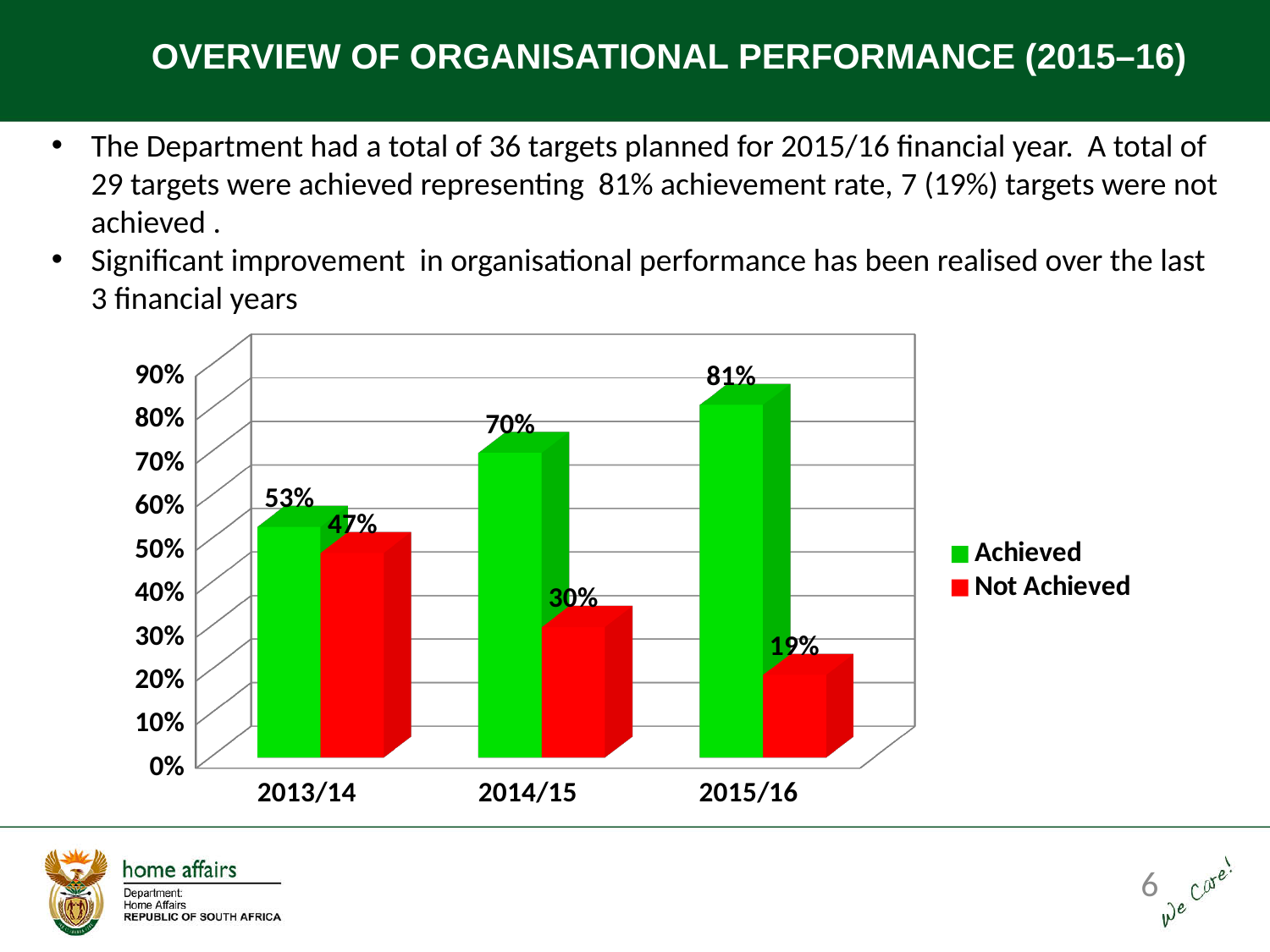
What is the Not Achieved value for 2013/14? 47% Which is larger for 2014/15, Achieved or Not Achieved? Achieved Do the Achieved values rise or fall from 2013/14 to 2015/16? Rise What colour represents the Not Achieved series? Red Which year has the lowest Not Achieved value? 2015/16 What is the difference between the Achieved values for 2015/16 and 2013/14? 28% What is the Not Achieved value for 2014/15? 30% What kind of chart is shown on the slide? Bar chart What is the Achieved value for 2015/16? 81% How many series does the legend list? 2 Which year has the highest Achieved value? 2015/16 How many years are shown on the x axis? 3